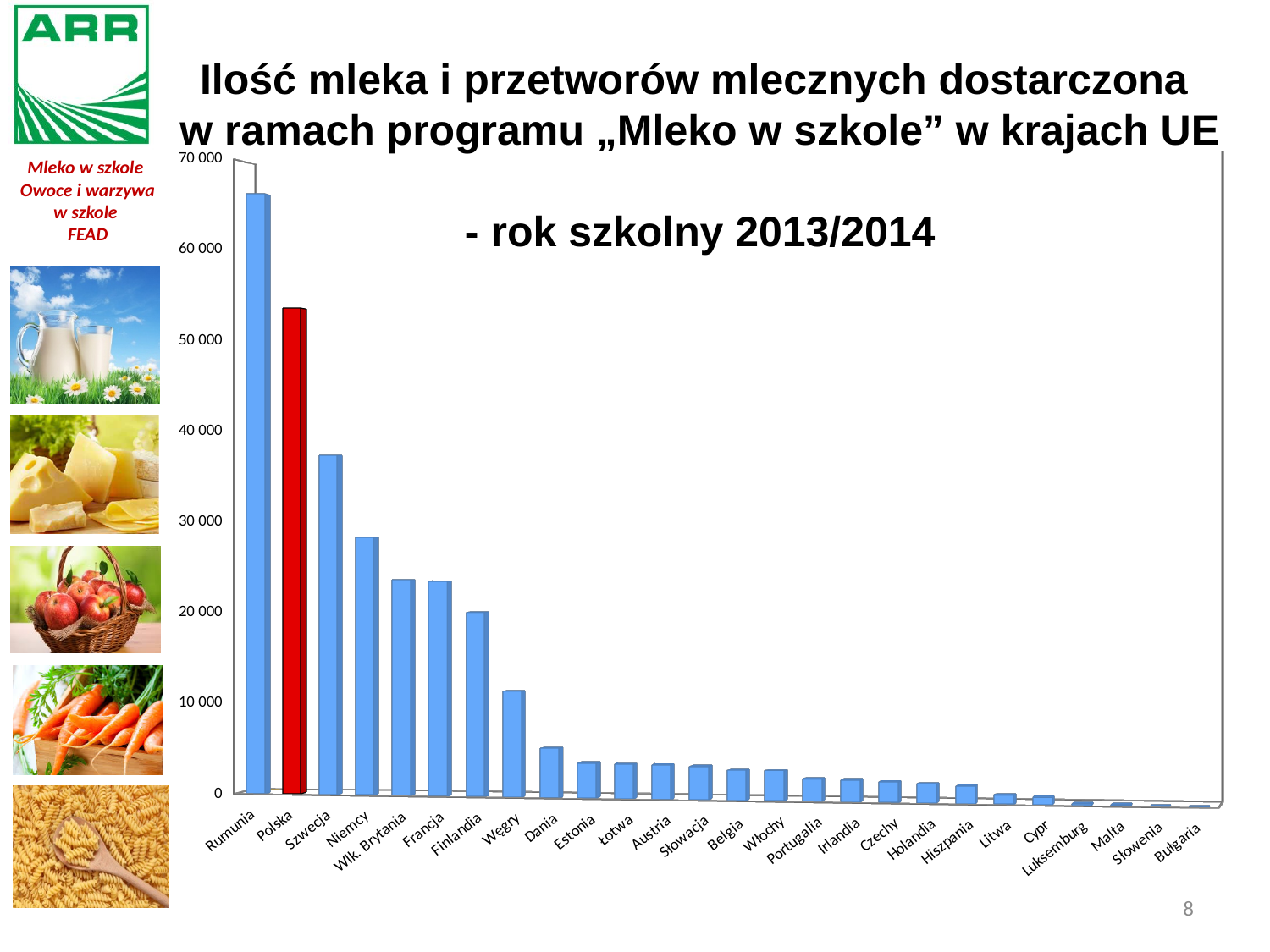
What kind of chart is shown on the slide? bar chart Do the values rise or fall moving from left to right along the x axis? fall Which country has the highest value in the chart? Rumunia Which has a larger value, Węgry or Francja? Francja Is the value for Rumunia greater or less than 60 000? greater Is the value for Polska greater or less than 50 000? greater How many countries are shown on the x axis of the chart? 26 Is the value for Niemcy greater or less than 30 000? less Which has a larger value, Polska or Szwecja? Polska Which country's bar is coloured red in the chart? Polska